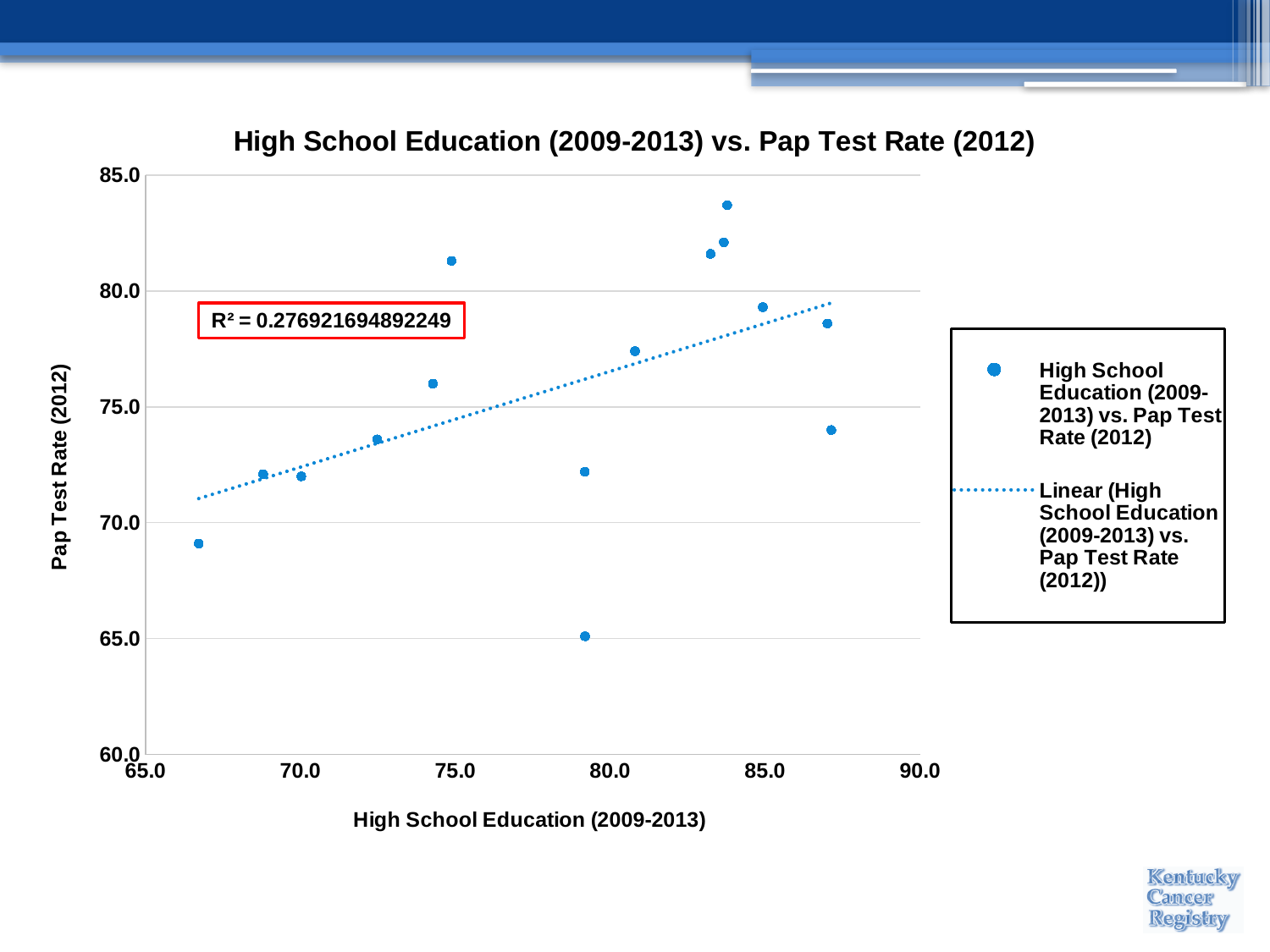
Is the Pap Test Rate of the lowest plotted point greater or less than 70.0? less What is the title of the chart? High School Education (2009-2013) vs. Pap Test Rate (2012) How many data points are plotted on the chart? 15 Does the dotted linear trendline rise or fall as High School Education increases along the x axis? Rises What is the maximum value shown on the vertical axis? 85.0 Is the Pap Test Rate of the leftmost plotted point (near 66.7 on the x axis) greater or less than 70.0? less What is the label of the vertical axis? Pap Test Rate (2012) How many entries does the legend list? 2 What R² value is printed on the chart? R² = 0.276921694892249 What is the minimum value shown on the horizontal axis? 65.0 Is the Pap Test Rate of the highest plotted point greater or less than 80.0? greater What kind of chart is shown on the slide? Scatter chart